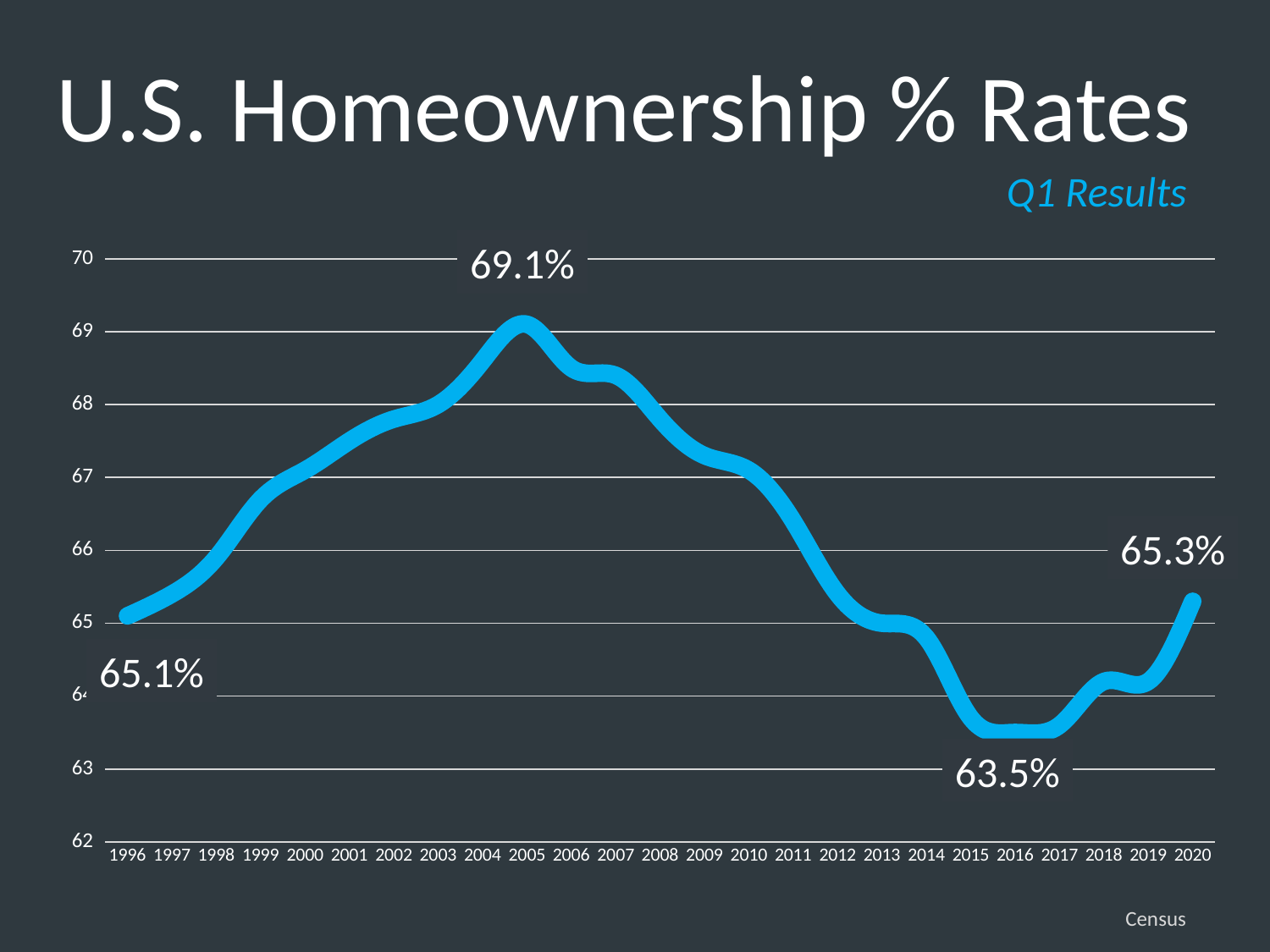
What is the homeownership rate shown for 2020? 65.3% What is the title of the chart? U.S. Homeownership % Rates Which is larger, the rate for 1996 or the rate for 2020? 2020 What is the homeownership rate shown for 1996? 65.1% How many years are shown on the x axis? 25 What is the homeownership rate shown for 2005? 69.1% Is the value for 2018 greater or less than 65? less What is the difference between the 2005 peak rate and the 2016 low rate? 5.6 percentage points Which year has the highest homeownership rate on the chart? 2005 What is the homeownership rate shown for 2016? 63.5% What kind of chart is shown on the slide? line chart